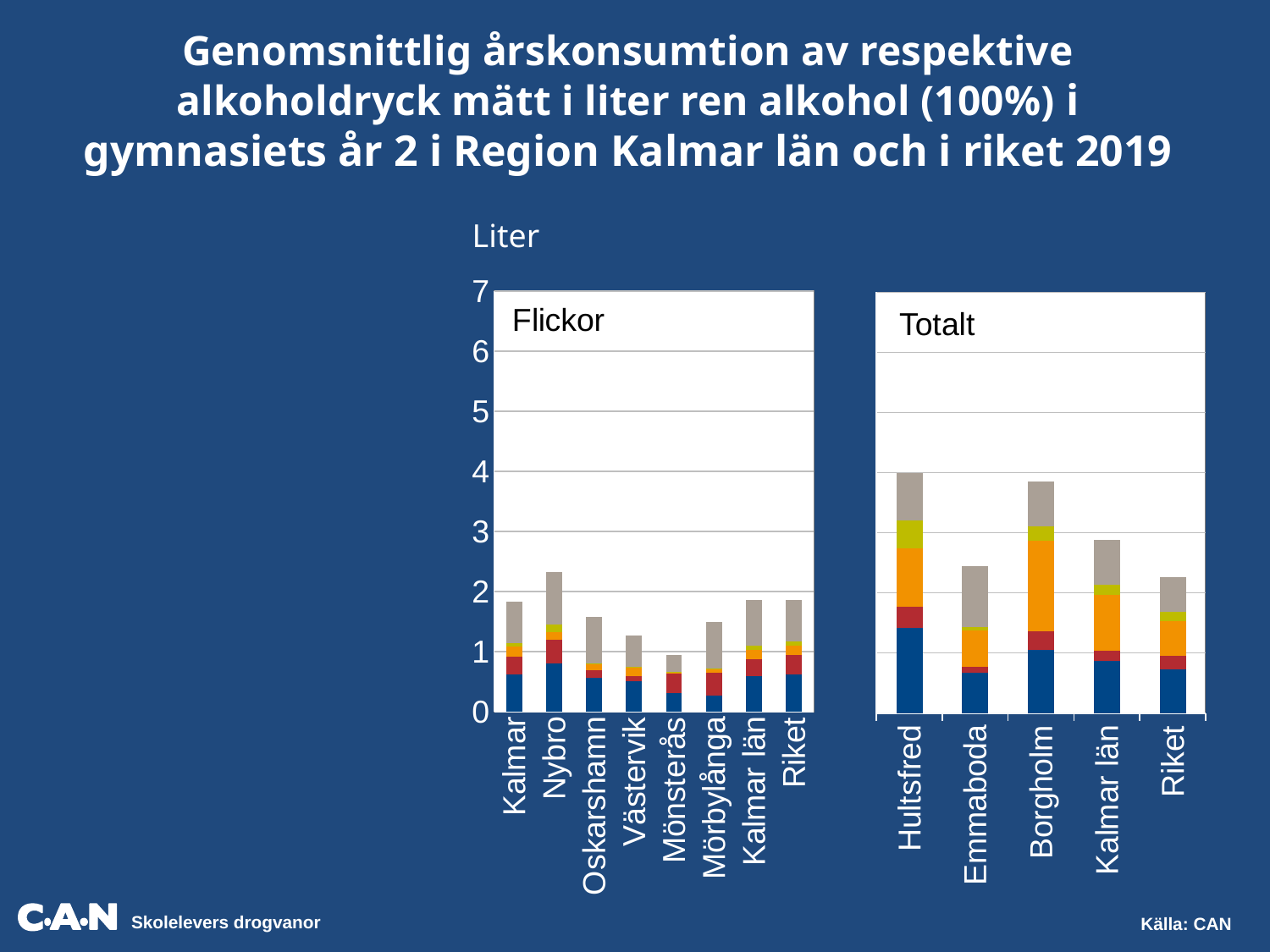
In the "Totalt" chart, is the total bar for Emmaboda greater or less than 3? less How many categories are shown on the x axis of the "Flickor" chart? 8 In the "Totalt" chart, is the total bar for Hultsfred greater or less than 3? greater How many categories are shown on the x axis of the "Totalt" chart? 5 What kind of chart is the "Flickor" chart on the left? Stacked bar chart In the "Flickor" chart, which category has the tallest bar? Nybro In the "Totalt" chart, which has the taller bar, Hultsfred or Emmaboda? Hultsfred What unit is shown as the label of the vertical axis? Liter In the "Flickor" chart, which category has the shortest bar? Mönsterås In the "Totalt" chart, which has the taller bar, Kalmar län or Riket? Kalmar län In the "Flickor" chart, is the total bar for Nybro greater or less than 2? greater